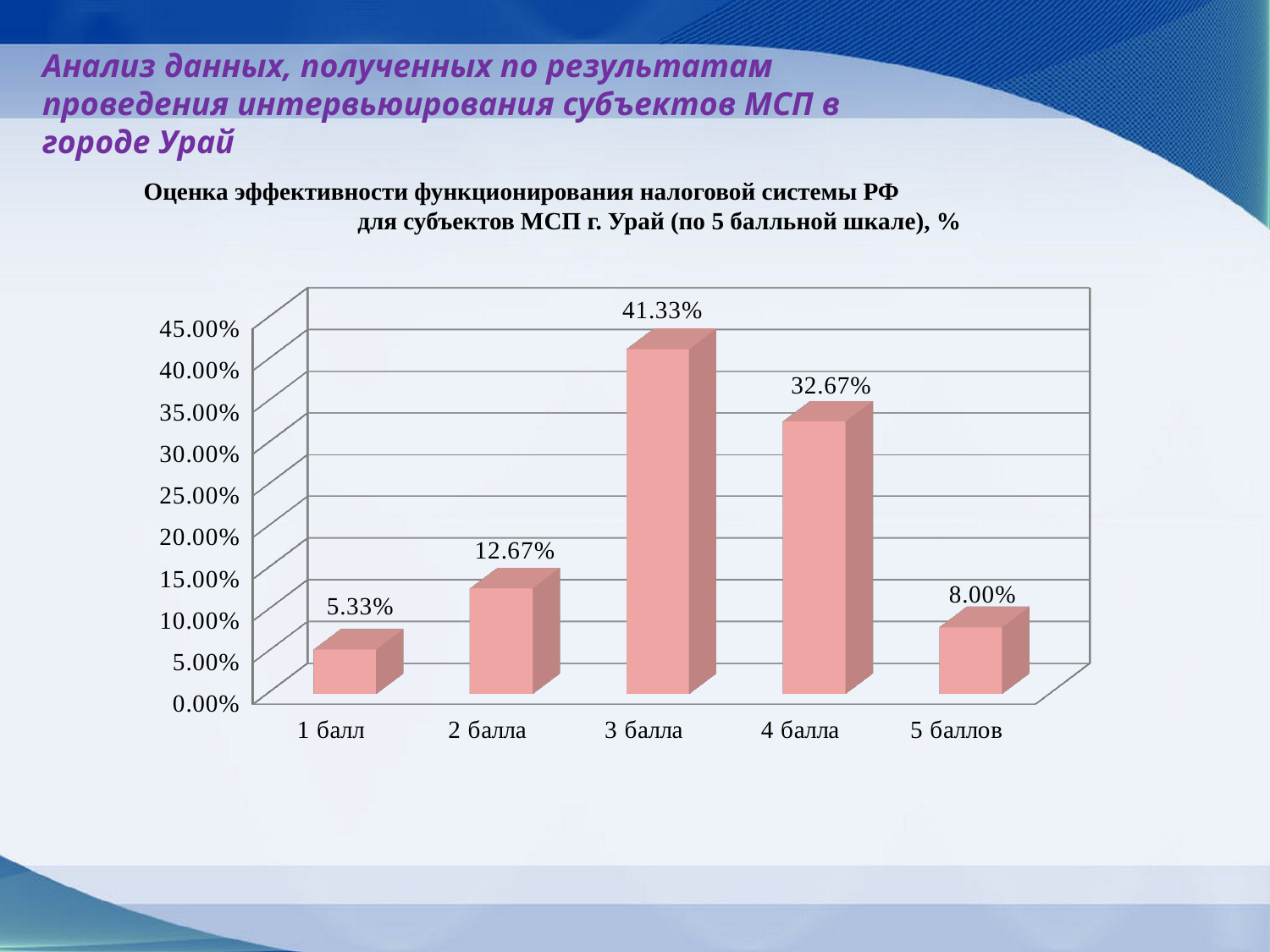
Is the value for 4 балла greater or less than 30.00%? greater What is the value for 3 балла? 41.33% What is the difference between the values for 3 балла and 4 балла? 8.66% What kind of chart is shown on the slide? bar chart What is the difference between the values for 2 балла and 1 балл? 7.34% Which category has the highest value? 3 балла Which category has the lowest value? 1 балл How many categories are shown on the x axis? 5 What is the value for 1 балл? 5.33% What is the highest value shown on the vertical axis? 45.00% Which is larger, the value for 2 балла or the value for 5 баллов? 2 балла What is the value for 5 баллов? 8.00%